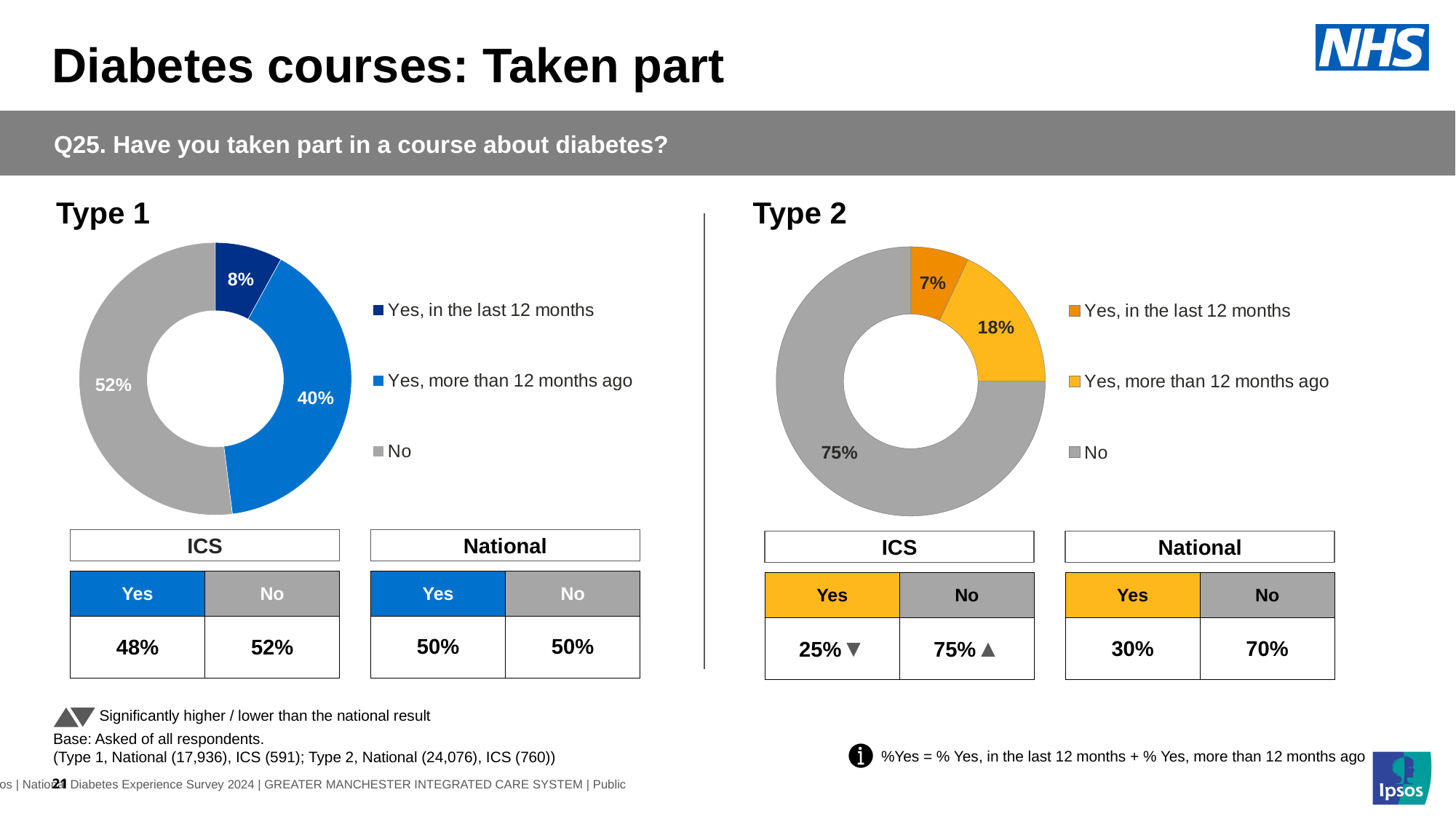
In the Type 2 chart, which response has the largest share? No What kind of chart is used for Type 1 and Type 2? Doughnut (pie) chart What colour represents 'No' in both the Type 1 and Type 2 charts? Grey Which is larger: the 'Yes, in the last 12 months' share in the Type 1 chart or in the Type 2 chart? Type 1 How many categories does the Type 2 chart's legend list? 3 In the Type 2 chart, what percentage answered 'Yes, more than 12 months ago'? 18% In the Type 1 chart, what percentage answered 'Yes, more than 12 months ago'? 40% In the Type 1 chart, which response has the smallest share? Yes, in the last 12 months In the Type 2 chart, what percentage answered 'Yes, in the last 12 months'? 7% In the Type 1 chart, what percentage of respondents answered 'No'? 52% In the Type 2 chart, what is the combined share of the two 'Yes' responses? 25% In the Type 1 chart, what is the difference between the 'No' share and the 'Yes, more than 12 months ago' share? 12%